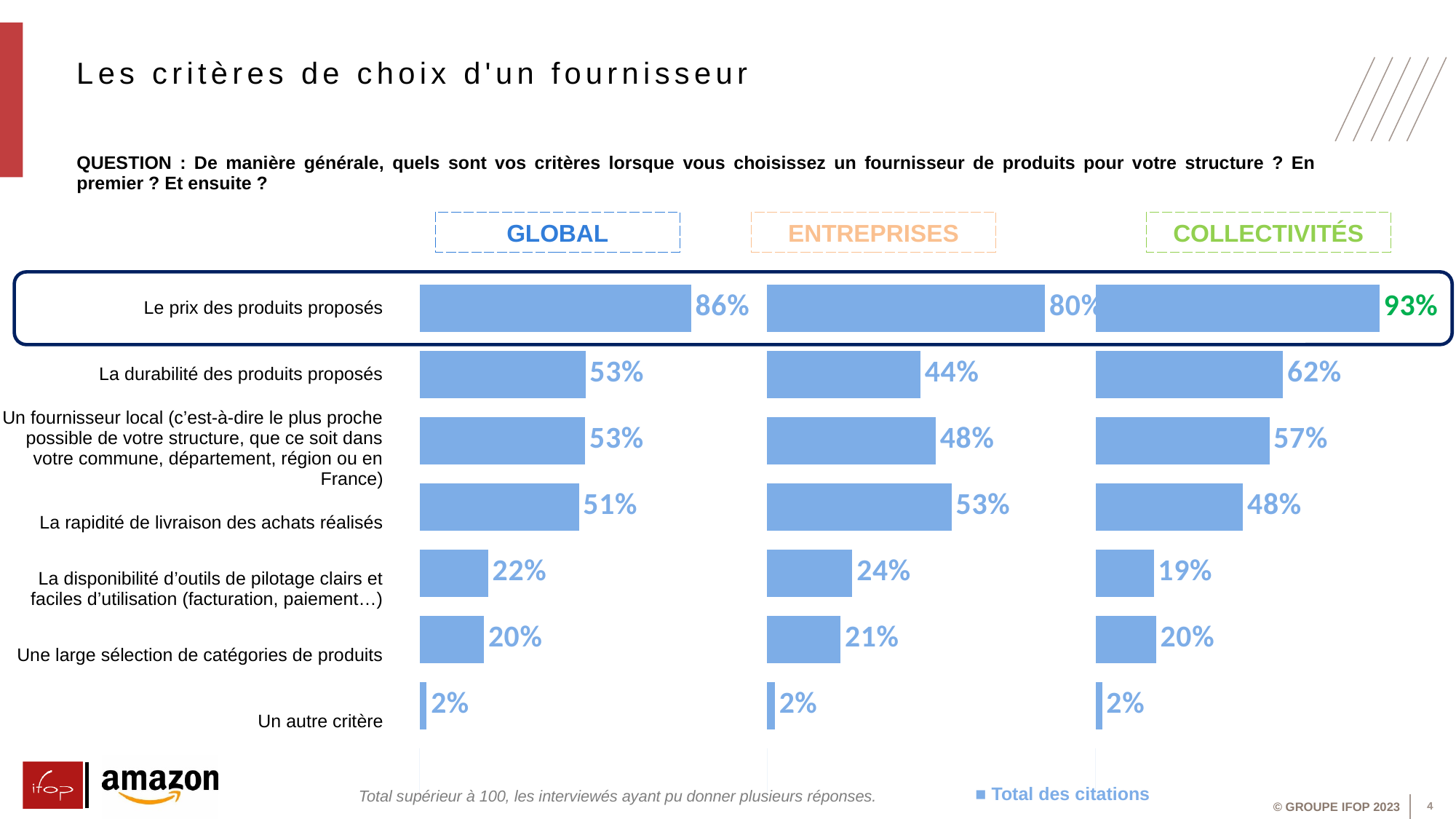
What kind of chart is used for the GLOBAL data? Bar chart What is the value for "Le prix des produits proposés" in the ENTREPRISES chart? 80% In the COLLECTIVITÉS chart, what is the difference between "Un fournisseur local" and "La rapidité de livraison des achats réalisés"? 9% In the GLOBAL chart, what is the difference between "Le prix des produits proposés" and "La durabilité des produits proposés"? 33% In the GLOBAL chart, what is the value for "Le prix des produits proposés"? 86% In the ENTREPRISES chart, what is the value for "La rapidité de livraison des achats réalisés"? 53% In the COLLECTIVITÉS chart, which category has the highest value? Le prix des produits proposés In the ENTREPRISES chart, which category has the lowest value? Un autre critère In the COLLECTIVITÉS chart, what is the value for "La durabilité des produits proposés"? 62% Which is larger in the ENTREPRISES chart: "La durabilité des produits proposés" or "Un fournisseur local"? Un fournisseur local How many categories are shown in the GLOBAL chart? 7 What series name does the legend at the bottom of the slide show? Total des citations